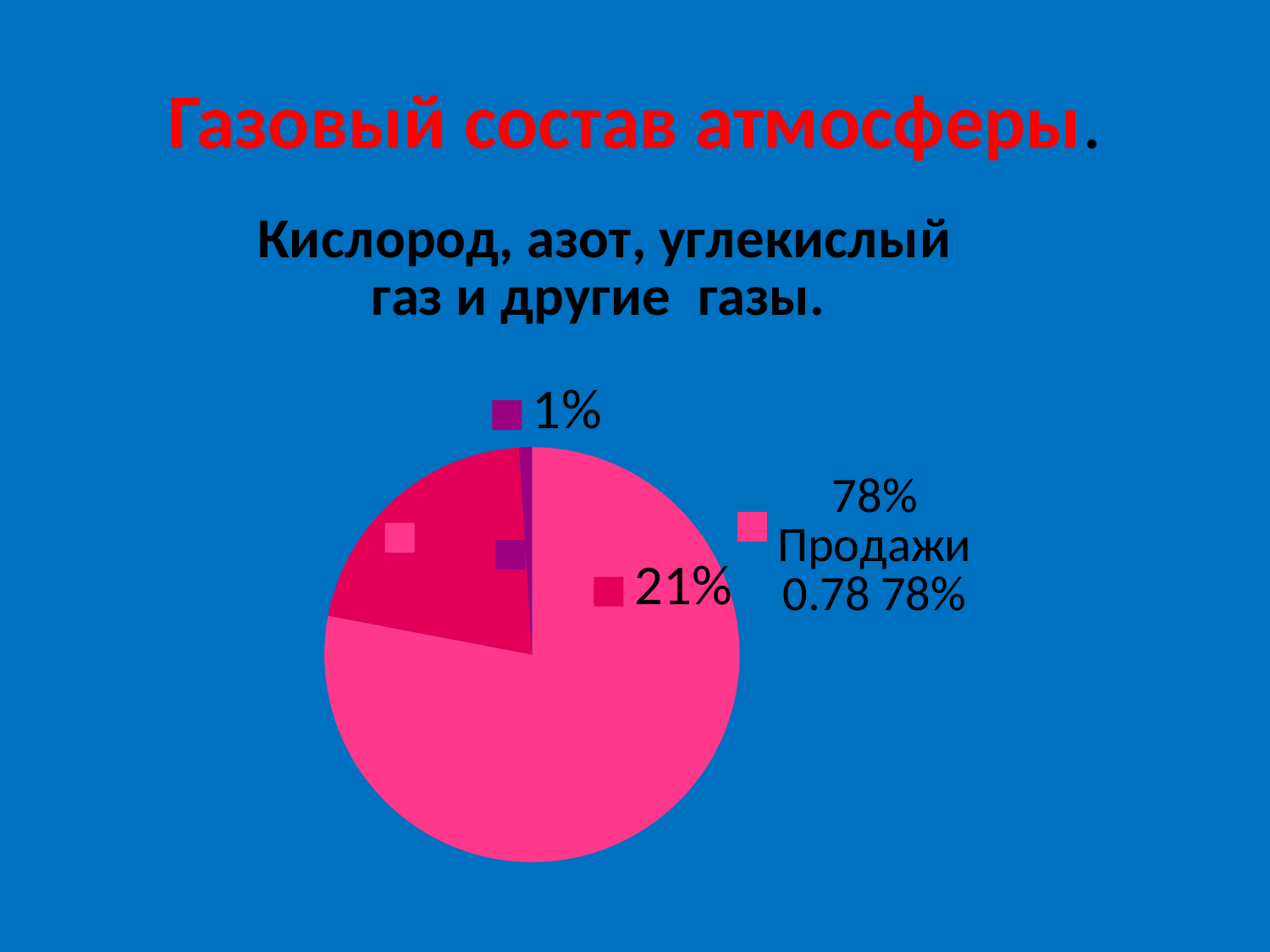
What percentage is shown for the slice labelled "Продажи"? 78% How many slices does the pie chart have? 3 What kind of chart is shown on the slide? pie chart What do the three percentage labels on the pie chart add up to? 100% What is the percentage shown for the largest slice of the pie chart? 78% What is the percentage shown for the smallest slice of the pie chart? 1% What text appears next to the 78% label on the pie chart? Продажи 0.78 78% Which slice is larger: the one labelled 21% or the one labelled 1%? 21% Is the largest slice of the pie chart greater or less than 50%? greater What is the title of the slide containing the pie chart? Газовый состав атмосферы. What is the difference in percentage points between the 78% slice and the 21% slice? 57 What is the difference in percentage points between the 21% slice and the 1% slice? 20